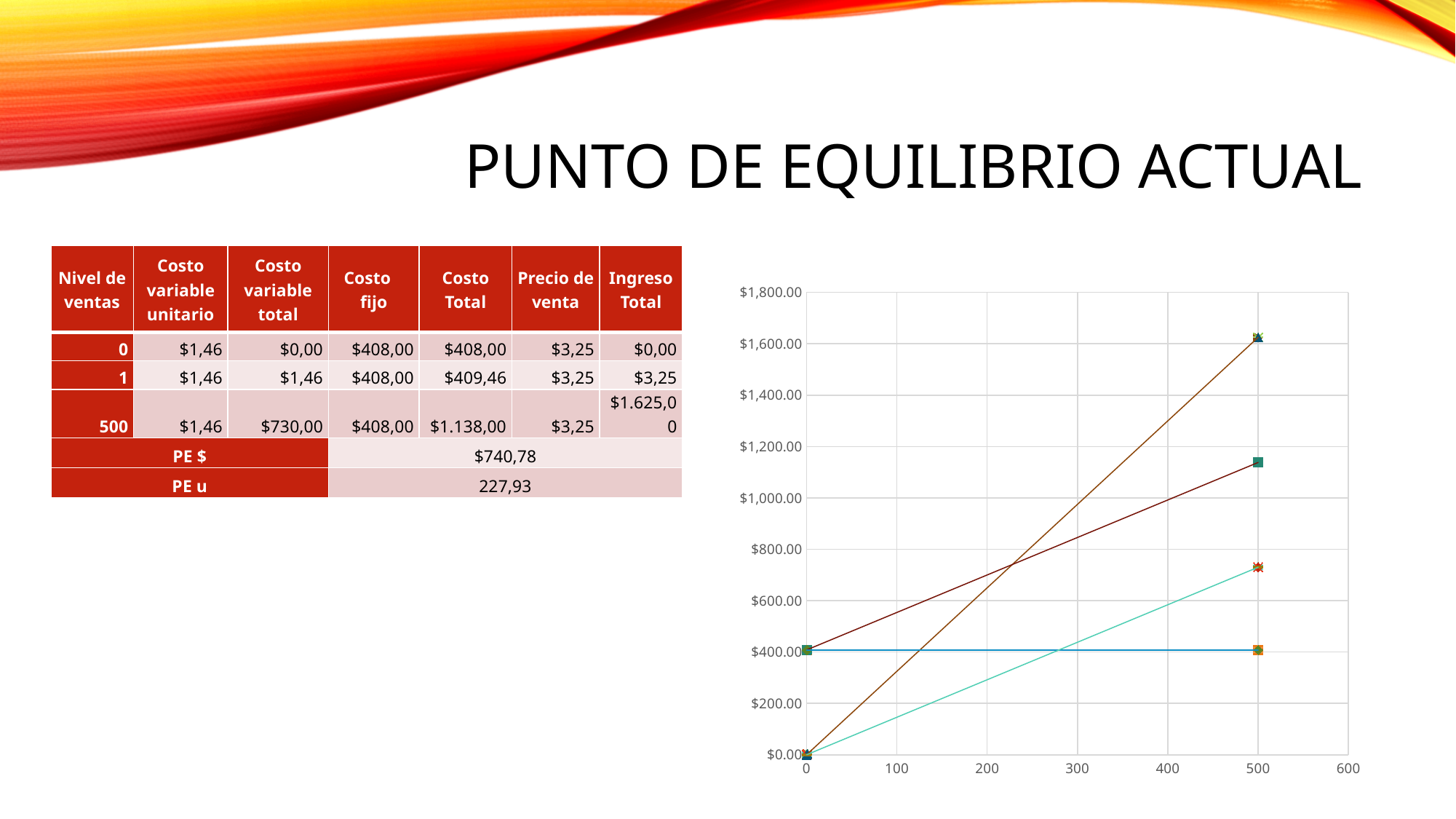
At x = 500, is the value of the steepest line greater or less than $1,400.00? greater At x = 500, is the value of the flat horizontal line greater or less than $600.00? less At x = 500, is the value of the lowest rising line (the one starting at $0.00) greater or less than $600.00? greater What is the highest value shown on the chart's horizontal axis? 600 How many lines are plotted on the chart? 4 Does the steepest line rise or fall as x increases from 0 to 500? rise Does the flat line change in value between x = 0 and x = 500? no What kind of chart is shown on the right of the slide? line chart At x = 500, which line has the highest value: the steepest line or the flat line? the steepest line What is the highest value shown on the chart's vertical axis? $1,800.00